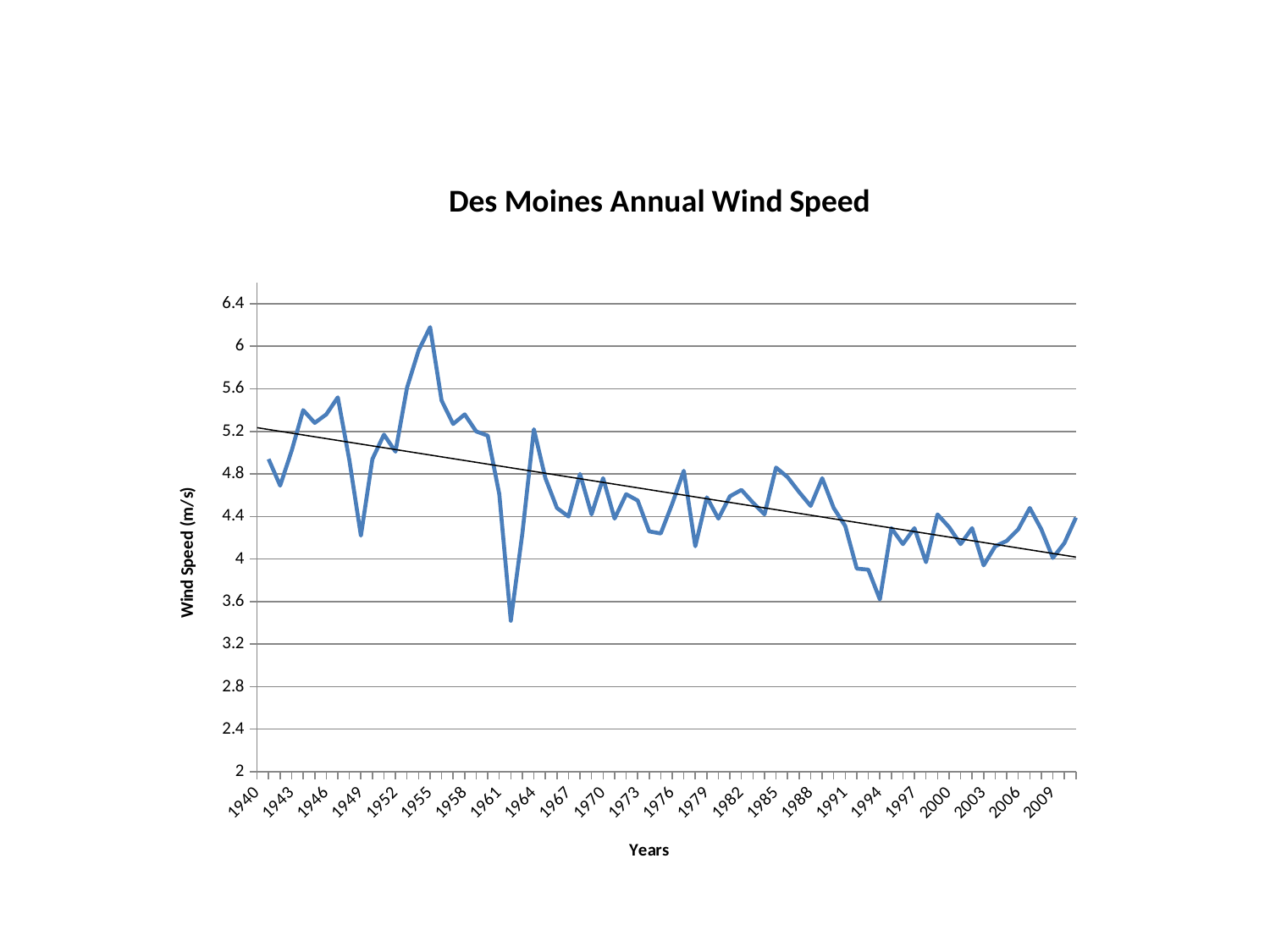
In which year is the annual wind speed highest? 1955 What is the label of the vertical axis? Wind Speed (m/s) Is the value for 1949 greater or less than 4.4? less Which year has the larger wind speed, 1955 or 1994? 1955 What kind of chart is shown on the slide? line chart What is the title of the chart? Des Moines Annual Wind Speed Is the value for 1962 greater or less than 3.6? less In which year is the annual wind speed lowest? 1962 Is the value for 1946 greater or less than 5.2? greater Overall, do the wind speed values rise or fall from 1940 to 2009? fall